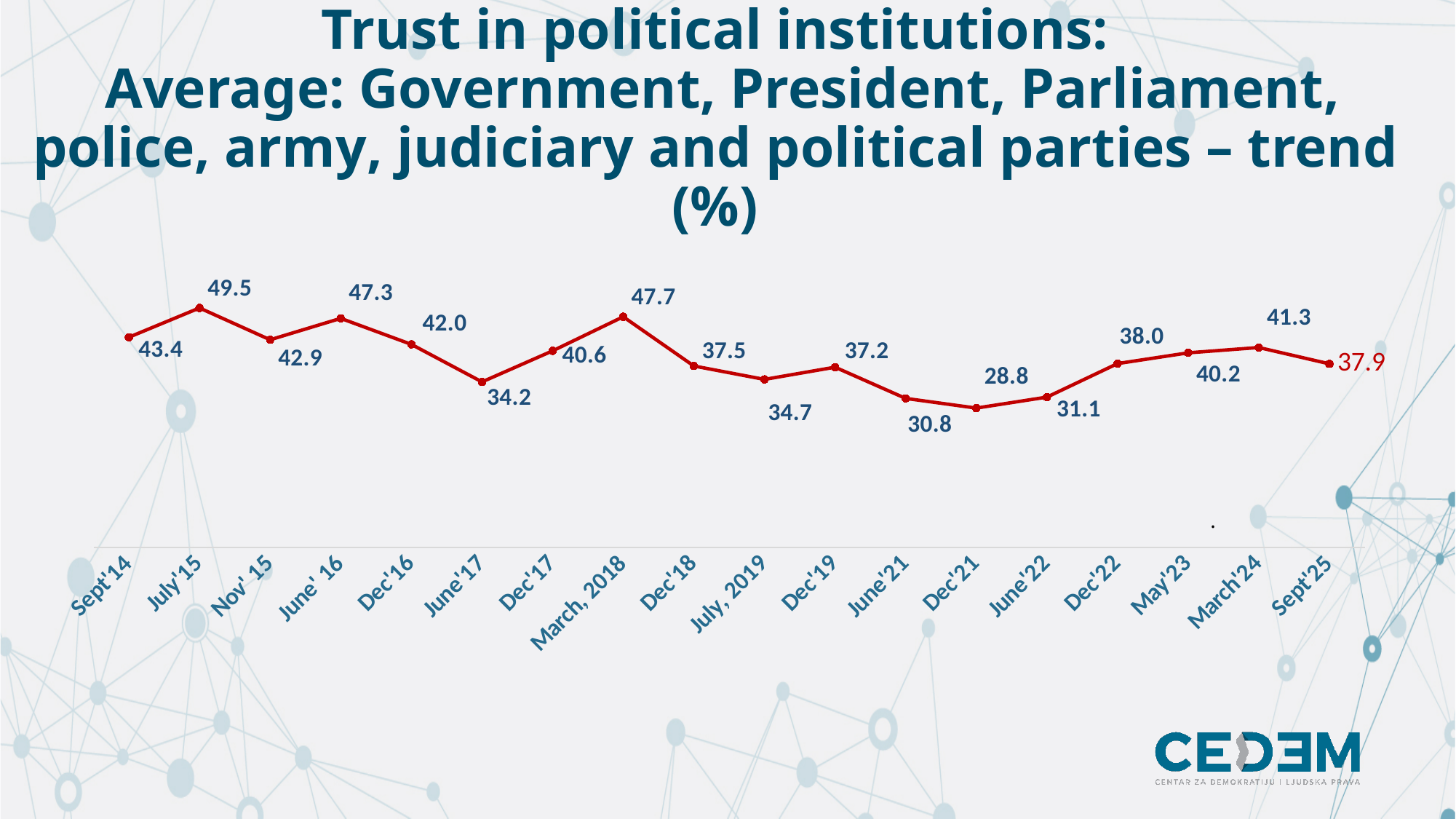
What is the value for June'17? 34.2 Do the values rise or fall from June'21 to Dec'21? Fall What is the value for Sept'25? 37.9 What is the difference between the values for July'15 and Sept'14? 6.1 Which period has the highest value? July'15 What is the difference between the values for March'24 and Sept'25? 3.4 Which is larger, the value for Dec'18 or the value for Dec'19? Dec'18 What kind of chart is shown on the slide? Line chart Which period has the lowest value? Dec'21 How many data points are plotted on the chart? 18 What is the value for March, 2018? 47.7 What is the value for Sept'14? 43.4